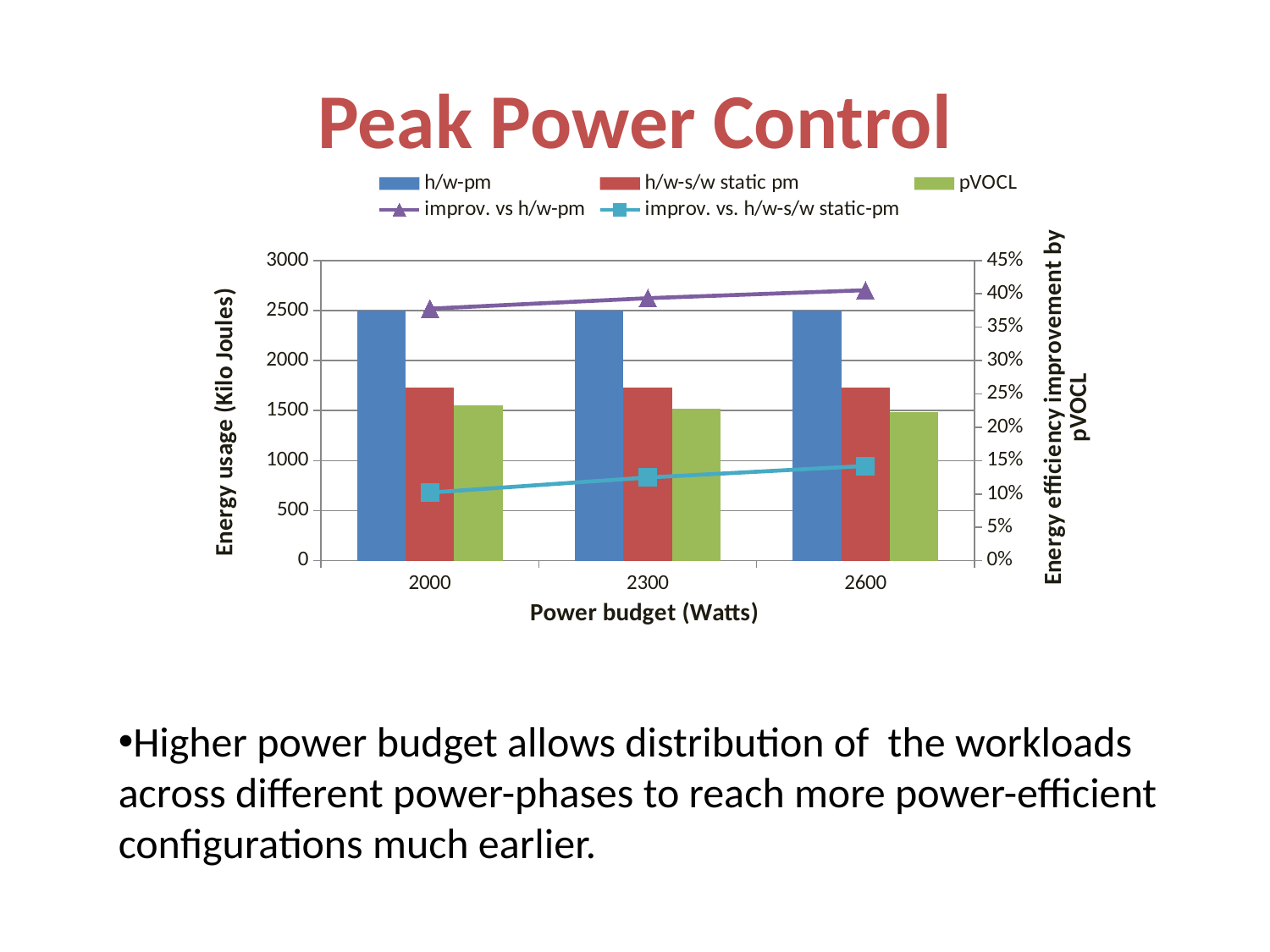
At a power budget of 2000 Watts, which has higher energy usage: h/w-pm or pVOCL? h/w-pm At which power budget is the improv. vs. h/w-s/w static-pm value highest? 2600 What is the title of the x axis? Power budget (Watts) Does the improv. vs h/w-pm line rise or fall as the power budget increases? Rises What kind of chart is shown on the slide? A combination bar and line chart Is the energy usage for h/w-s/w static pm at a power budget of 2000 Watts greater or less than 1500? greater Is the improv. vs h/w-pm value at a power budget of 2000 Watts greater or less than 35%? greater How many power budget categories are shown on the x axis? 3 How many series does the legend list? 5 Is the energy usage for pVOCL at a power budget of 2600 Watts greater or less than 2000? less